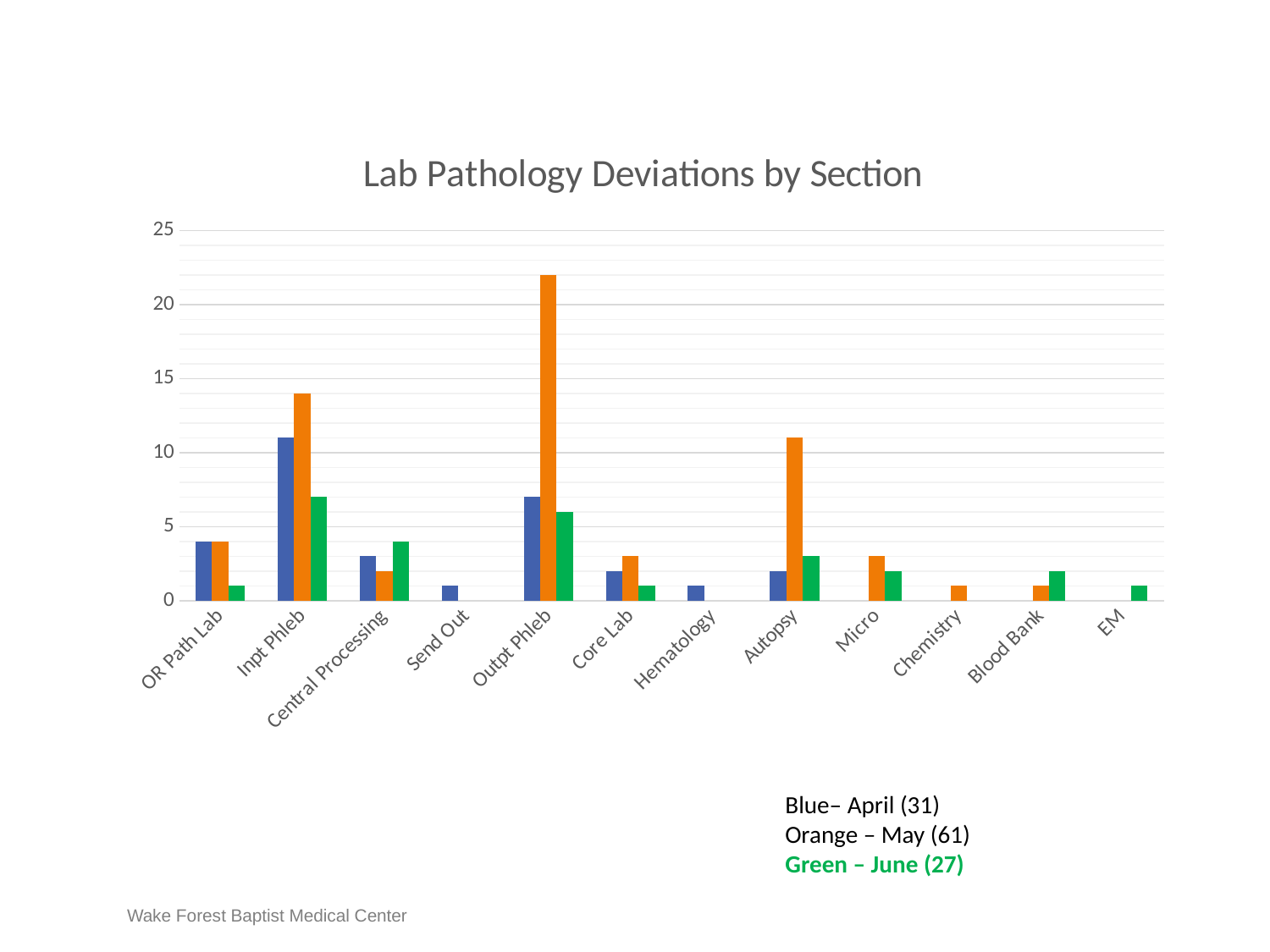
Is the May (orange) value for Inpt Phleb greater or less than 15? less Is the May (orange) value for Autopsy greater or less than 5? greater How many sections are shown along the x axis of the chart? 12 For April (blue), which section has the larger value: Inpt Phleb or Outpt Phleb? Inpt Phleb How many months (series) does the colour key below the chart list? 3 What kind of chart is shown on the slide? bar chart Is the May (orange) value for Outpt Phleb greater or less than 20? greater According to the colour key, what total is given for May? 61 Which section has the highest orange (May) bar? Outpt Phleb For Central Processing, which is larger: the May (orange) bar or the June (green) bar? June (green) Which section has the highest blue (April) bar? Inpt Phleb